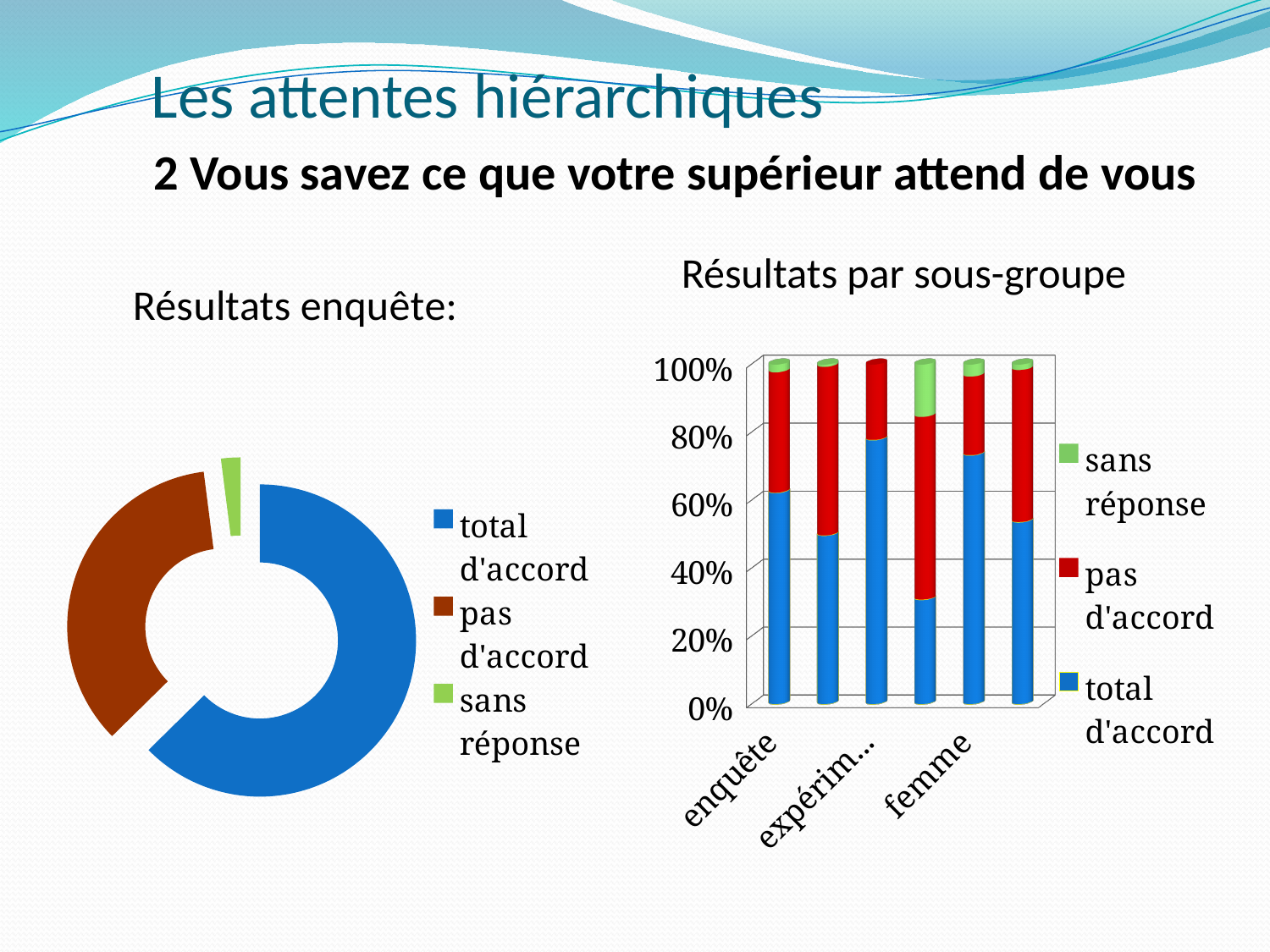
How many bars are plotted in the right chart 'Résultats par sous-groupe'? 6 How many entries does the legend of the left chart 'Résultats enquête:' list? 3 What is the title of the right chart on the slide? Résultats par sous-groupe What kind of chart is the left chart titled 'Résultats enquête:'? doughnut (pie) chart In the left chart 'Résultats enquête:', which is larger, 'total d'accord' or 'pas d'accord'? total d'accord In the left chart 'Résultats enquête:', which category has the largest share? total d'accord In the right chart 'Résultats par sous-groupe', which colour represents 'pas d'accord'? red What kind of chart is the right chart titled 'Résultats par sous-groupe'? stacked bar chart In the right chart 'Résultats par sous-groupe', is the 'total d'accord' value for 'enquête' greater or less than 80%? less How many series does the legend of the right chart 'Résultats par sous-groupe' list? 3 In the left chart 'Résultats enquête:', which category has the smallest share? sans réponse In the right chart 'Résultats par sous-groupe', is the 'total d'accord' value for 'enquête' greater or less than 40%? greater